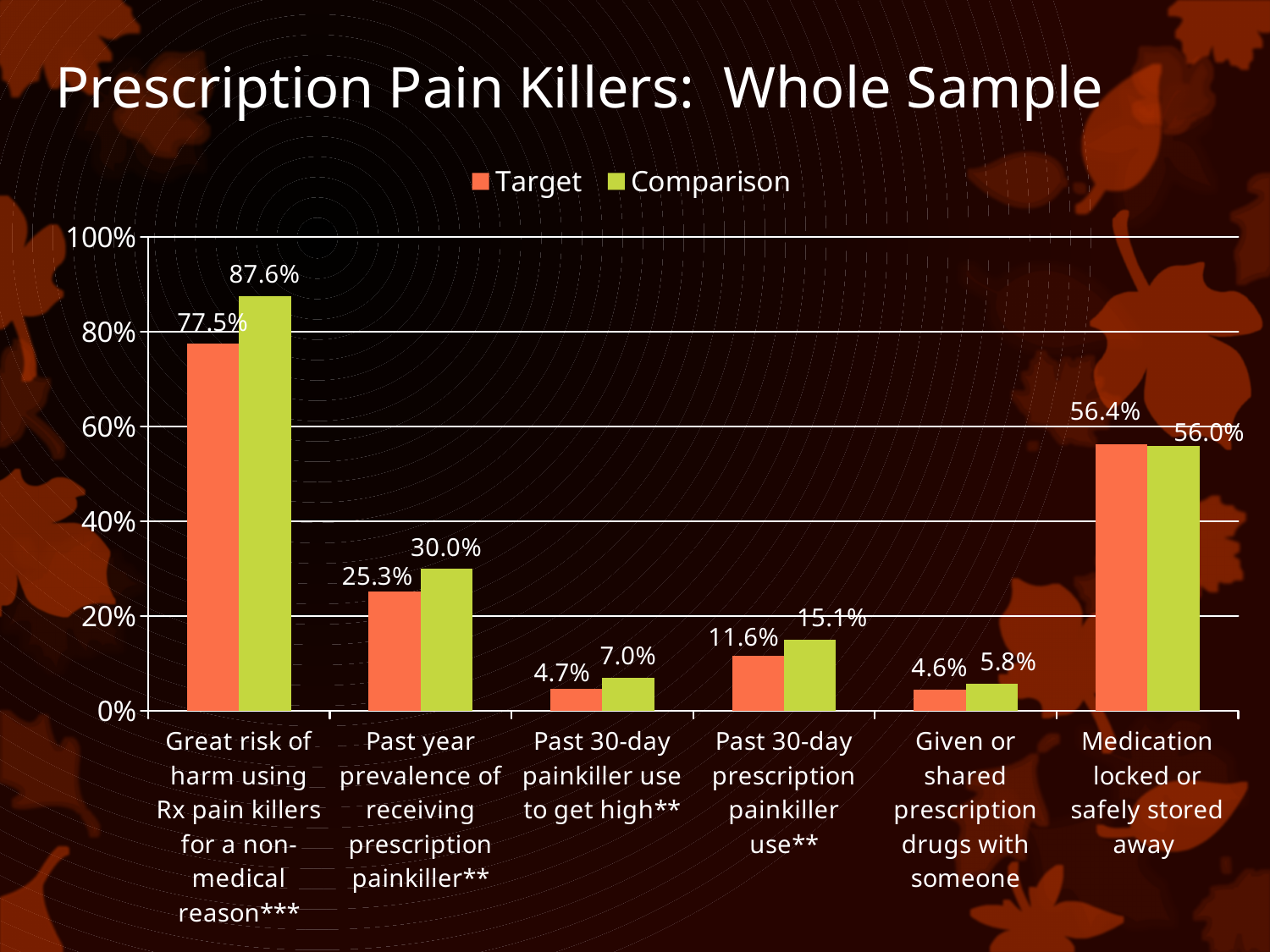
What is the Target value for "Past year prevalence of receiving prescription painkiller"? 25.3% What type of chart is shown on the slide? Bar chart What is the difference between the Comparison and Target values for "Great risk of harm using Rx pain killers for a non-medical reason"? 10.1% Which category has the lowest Target value? Given or shared prescription drugs with someone For "Past 30-day prescription painkiller use", which series has the larger value, Target or Comparison? Comparison What is the difference between the Comparison and Target values for "Past 30-day painkiller use to get high"? 2.3% How many series does the legend list? 2 What is the Comparison value for "Past 30-day prescription painkiller use"? 15.1% How many categories are shown on the x axis? 6 What is the Comparison value for "Great risk of harm using Rx pain killers for a non-medical reason"? 87.6% What is the Target value for "Medication locked or safely stored away"? 56.4% Which category has the highest Comparison value? Great risk of harm using Rx pain killers for a non-medical reason